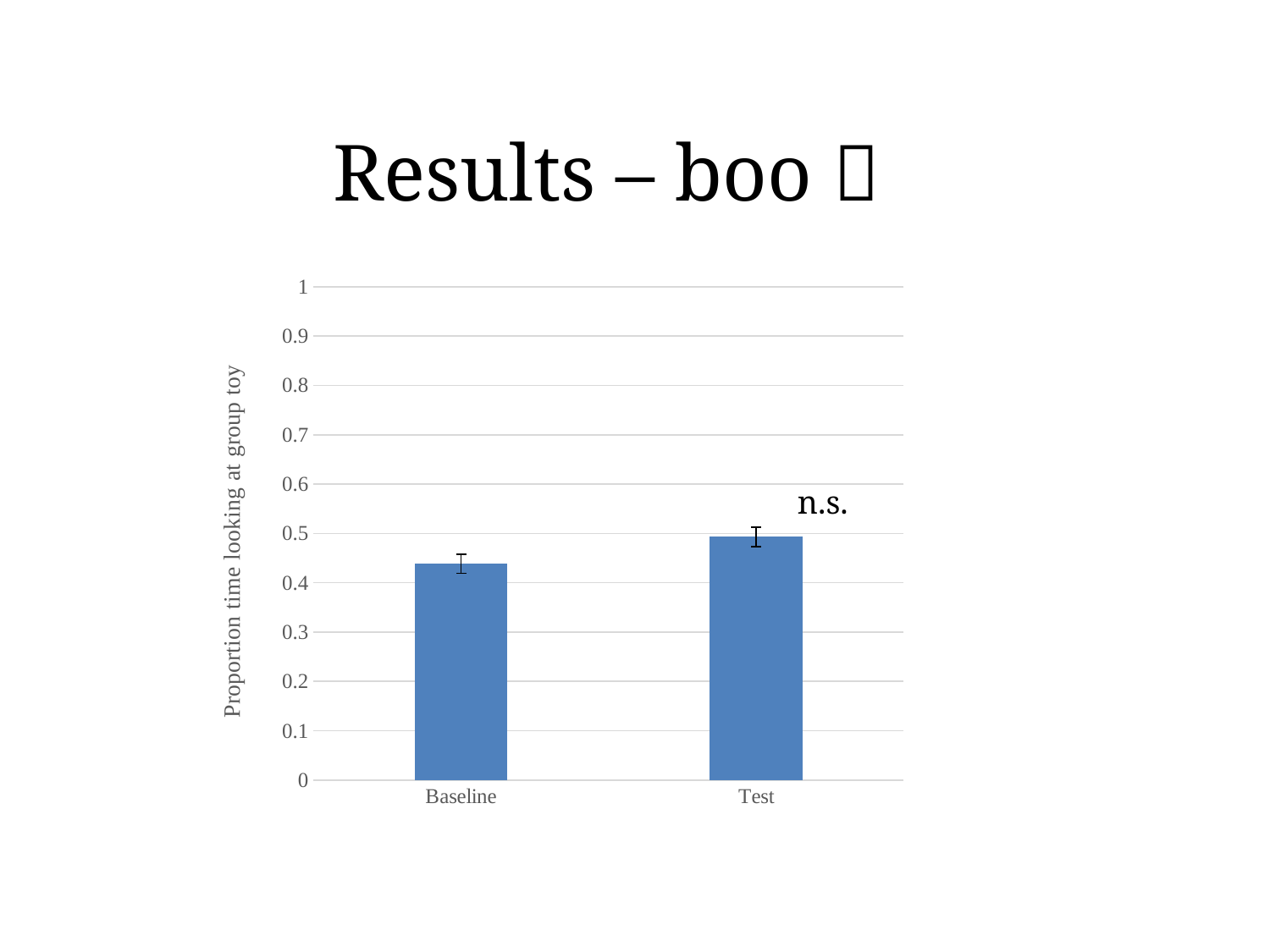
Which category has the higher bar? Test Is the value for Test greater or less than 0.6? less Which category has the lower bar? Baseline Is the value for Baseline larger or smaller than the value for Test? smaller How many categories are plotted on the x axis? 2 Is the value for Test greater or less than 0.4? greater What is the label on the y axis of the chart? Proportion time looking at group toy What kind of chart is shown on the slide? bar chart Is the value for Baseline greater or less than 0.4? greater What annotation is written above the Test bar? n.s. Do the bar values rise or fall from Baseline to Test? rise